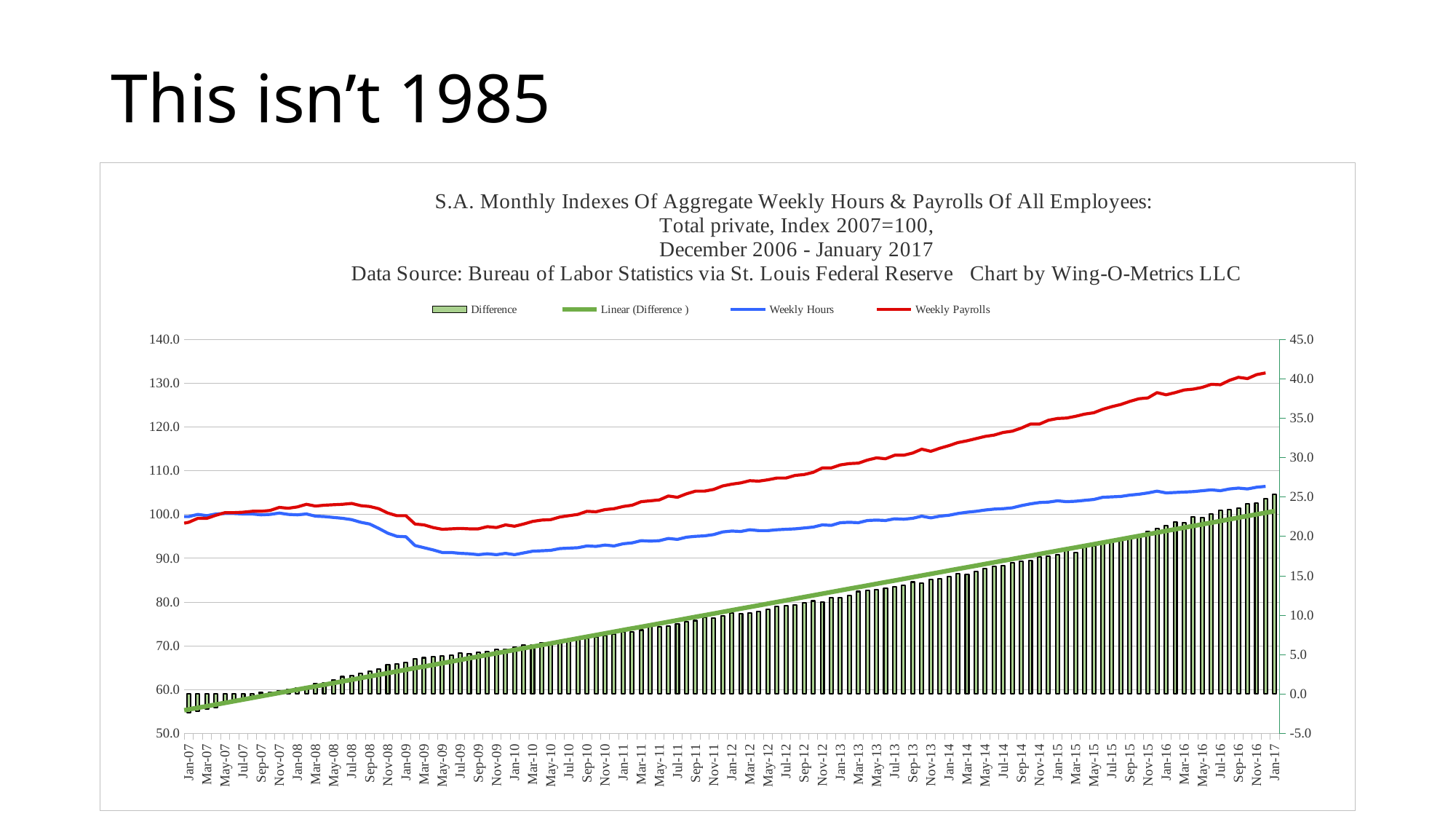
Is the Weekly Hours value at Jan-17 greater or less than 100.0 on the left axis? greater According to the chart title, what is the data source? Bureau of Labor Statistics via St. Louis Federal Reserve Which series reaches the highest value on the left axis at the end of the period? Weekly Payrolls Do the Difference bars generally rise or fall from left to right? Rise How many series does the chart legend list? 4 What kind of chart is this? A combination chart with bars and lines At Jan-17, which is larger: Weekly Payrolls or Weekly Hours? Weekly Payrolls What colour is the Weekly Payrolls line? Red Is the Weekly Payrolls value at Jan-17 greater or less than 120.0 on the left axis? greater Is the Difference bar at Jan-17 greater or less than 20.0 on the right axis? greater Does the Weekly Payrolls line rise or fall overall from Jan-07 to Jan-17? Rises